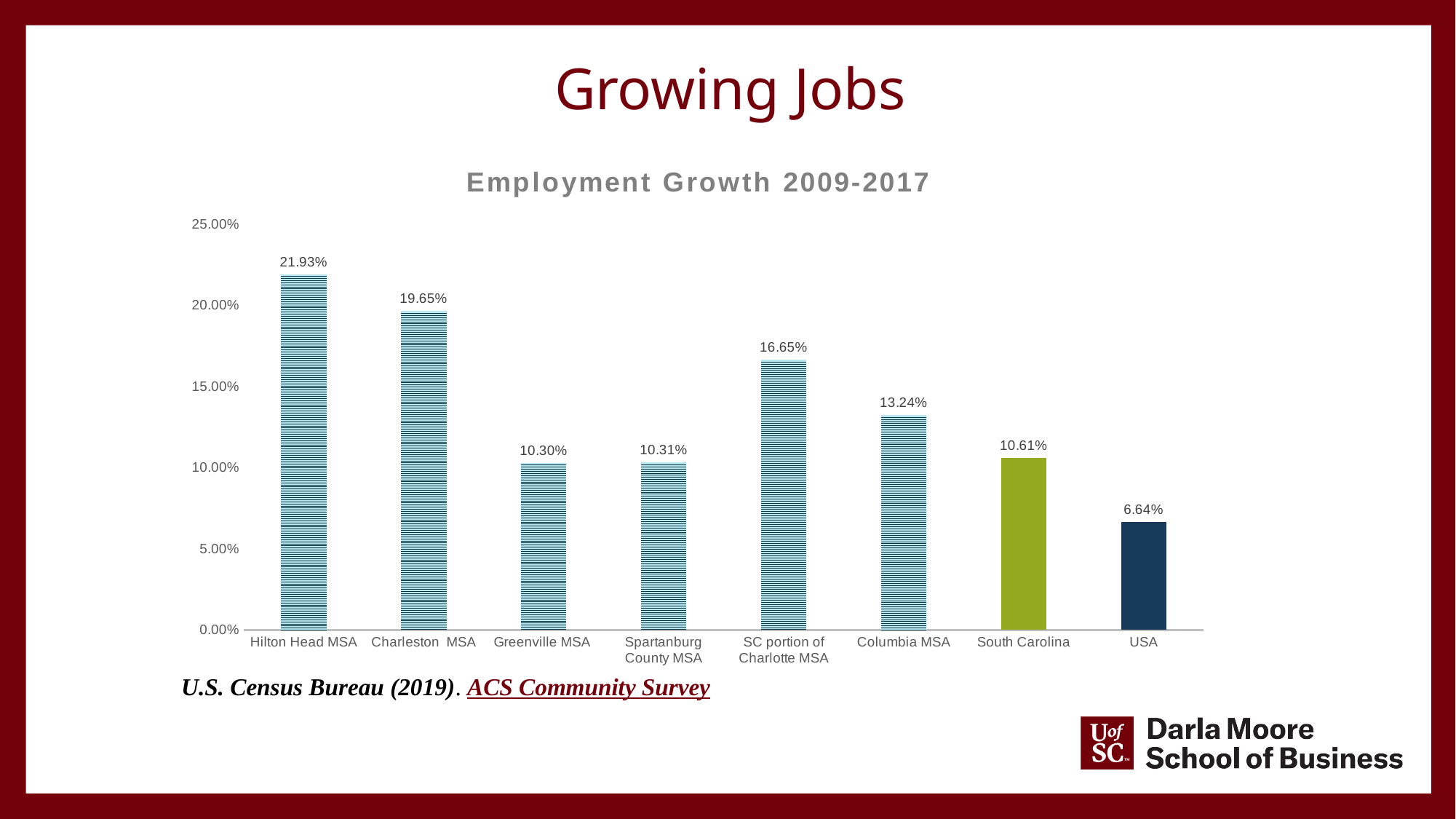
What is the employment growth value for the SC portion of Charlotte MSA? 16.65% What is the difference between the employment growth of South Carolina and the USA? 3.97% What kind of chart is shown on the slide? Bar chart What is the employment growth value for South Carolina? 10.61% What is the employment growth value for the USA? 6.64% What is the title of the chart? Employment Growth 2009-2017 Which category has the lowest employment growth? USA What is the difference between the employment growth of Hilton Head MSA and Charleston MSA? 2.28% How many categories are shown on the chart? 8 What is the employment growth value for Hilton Head MSA? 21.93% Which category has the highest employment growth? Hilton Head MSA Which has higher employment growth, Columbia MSA or South Carolina? Columbia MSA